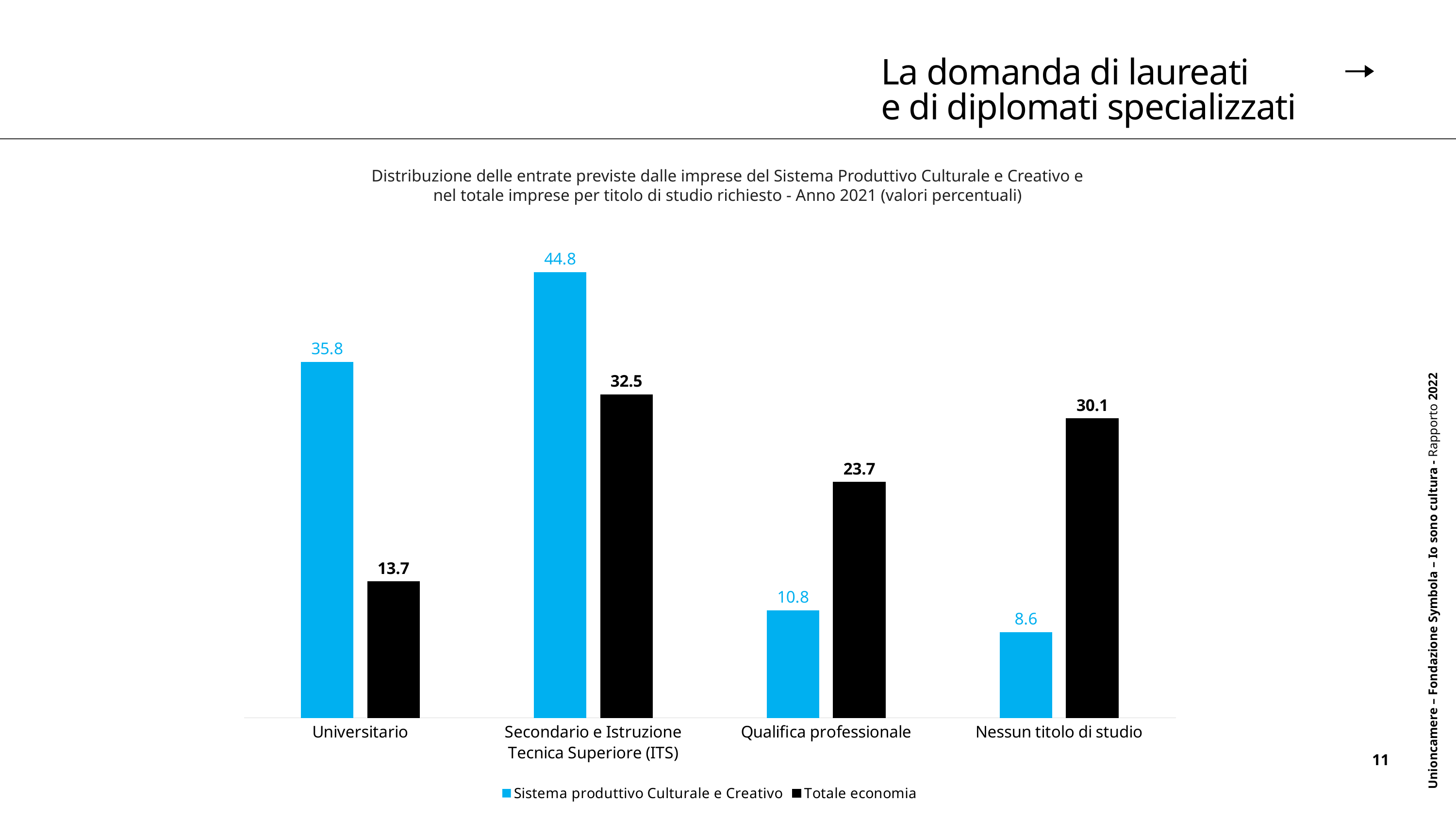
Which category has the highest value in the Sistema produttivo Culturale e Creativo series? Secondario e Istruzione Tecnica Superiore (ITS) What kind of chart is shown on the slide? Bar chart Which colour represents the Totale economia series? Black What is the difference between the Sistema produttivo Culturale e Creativo and Totale economia values for Universitario? 22.1 How many series does the legend list? 2 What is the value for Universitario in the Sistema produttivo Culturale e Creativo series? 35.8 How many categories are shown on the x axis? 4 For Nessun titolo di studio, which series has the larger value: Sistema produttivo Culturale e Creativo or Totale economia? Totale economia What is the difference between the Totale economia values for Secondario e Istruzione Tecnica Superiore (ITS) and Qualifica professionale? 8.8 What is the value for Qualifica professionale in the Sistema produttivo Culturale e Creativo series? 10.8 Which category has the lowest value in the Totale economia series? Universitario What is the value for Nessun titolo di studio in the Totale economia series? 30.1